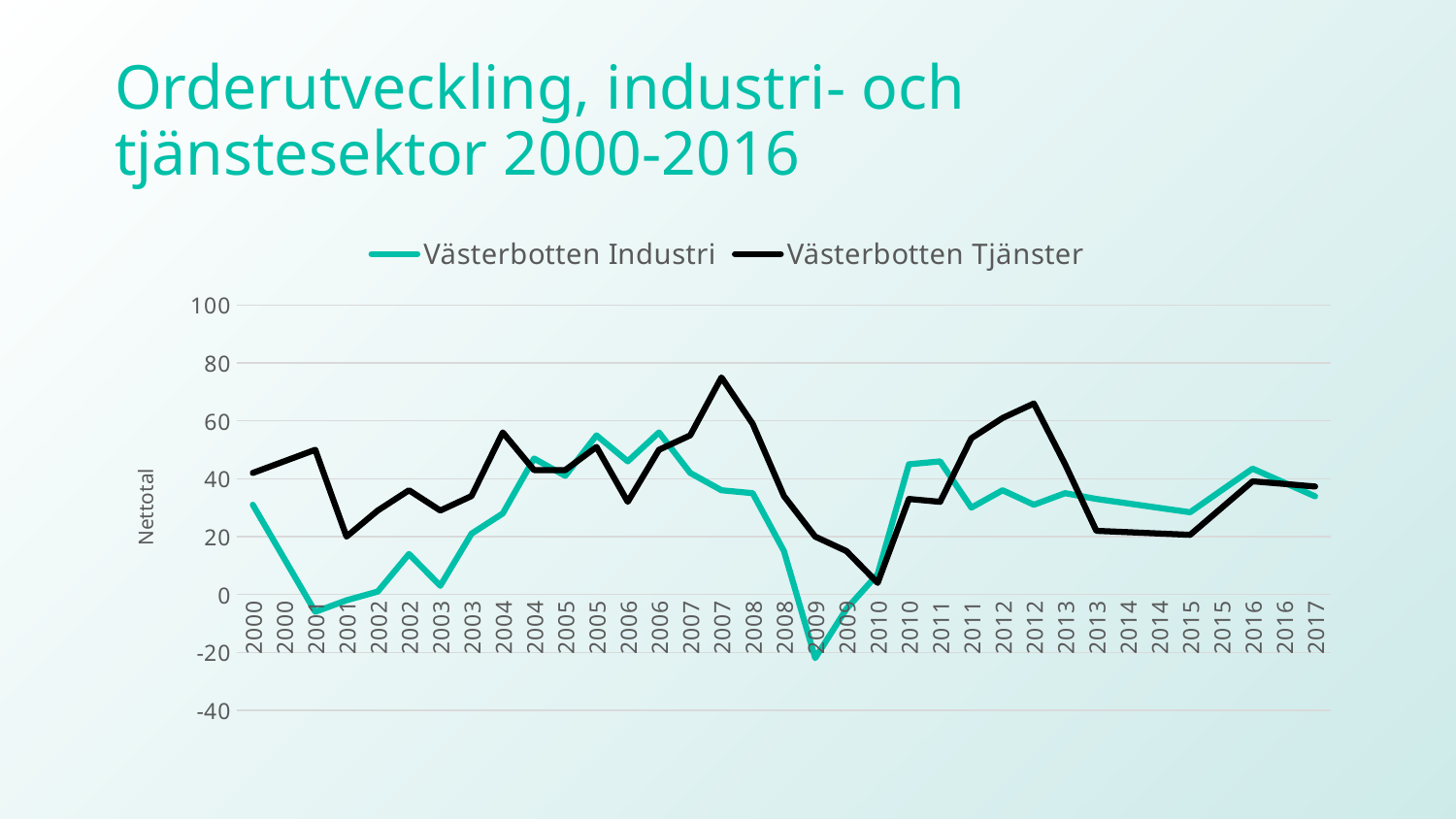
At the second 2010 point, which series has the larger value, Västerbotten Industri or Västerbotten Tjänster? Västerbotten Industri Is the peak value of Västerbotten Tjänster in 2007 greater or less than 60? greater Does the Västerbotten Tjänster line rise or fall between its 2012 peak and 2013? fall What kind of chart is shown on the slide? line chart How many series does the legend list? 2 Is the lowest value of Västerbotten Industri in 2009 greater or less than 0? less At the second 2007 point, which series has the larger value, Västerbotten Industri or Västerbotten Tjänster? Västerbotten Tjänster Is the value of Västerbotten Industri at the first 2003 point greater or less than 20? less Which series reaches the lowest value anywhere on the chart? Västerbotten Industri Which series reaches the highest value anywhere on the chart? Västerbotten Tjänster What is the title of the chart on the slide? Orderutveckling, industri- och tjänstesektor 2000-2016 What is the label on the vertical axis? Nettotal